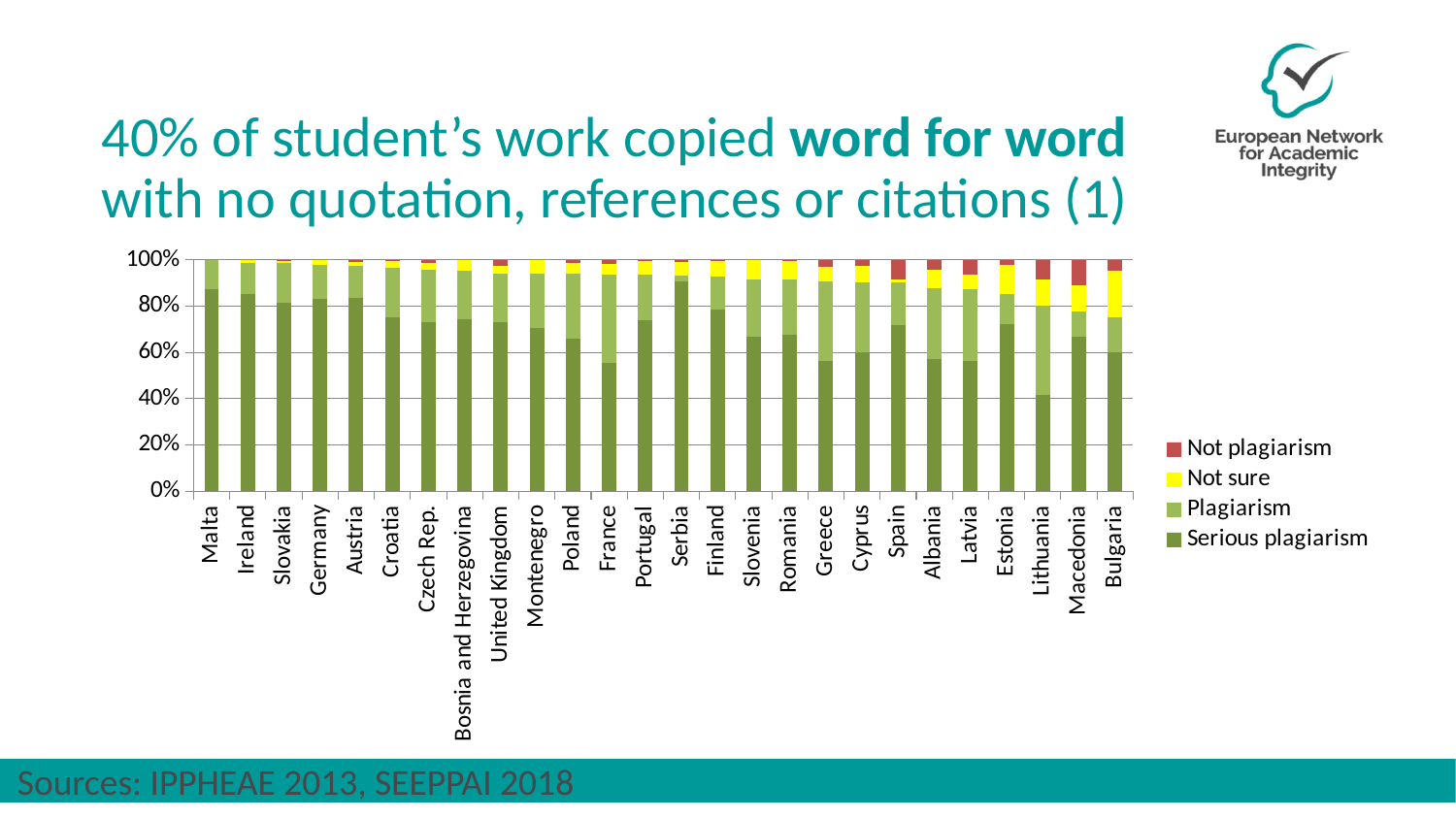
Which legend entry is shown in red? Not plagiarism How many countries are shown on the x axis of the chart? 26 Is the Serious plagiarism value for Serbia greater or less than 80%? greater Which country has the lowest share of Serious plagiarism? Lithuania What kind of chart is shown on the slide? Stacked bar chart Which has a larger Serious plagiarism share, Germany or France? Germany Is the Serious plagiarism value for France greater or less than 60%? less How many series does the legend list? 4 What is the total of each stacked bar in the chart? 100% Is the Serious plagiarism value for Malta greater or less than 80%? greater Which has a larger Serious plagiarism share, Malta or Lithuania? Malta